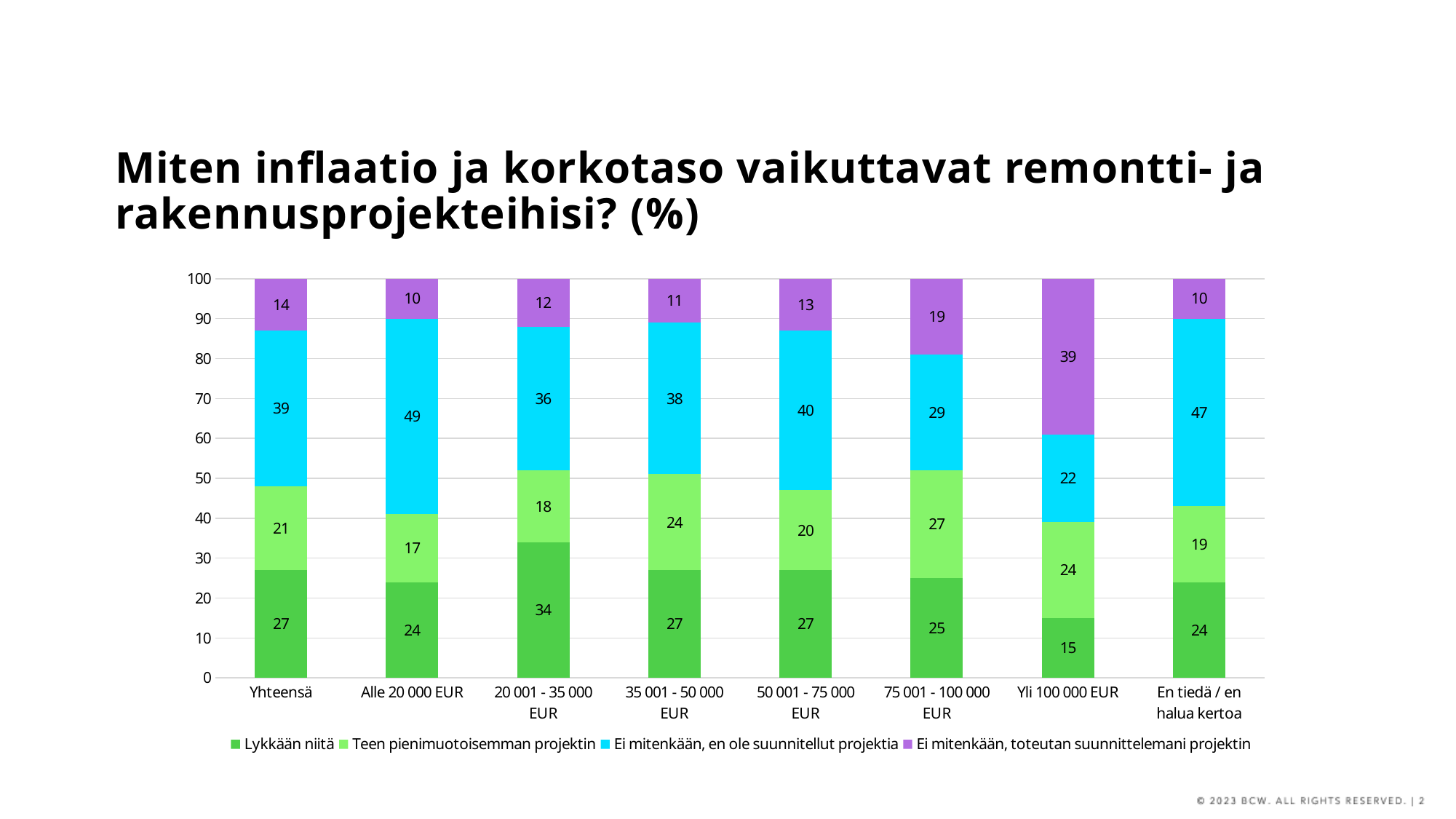
What is the total of the stacked bar for "Yli 100 000 EUR"? 100 Which category has the highest value for "Lykkään niitä"? 20 001 - 35 000 EUR Which category has the lowest value for "Ei mitenkään, en ole suunnitellut projektia"? Yli 100 000 EUR How many categories are shown on the x axis? 8 What kind of chart is shown on the slide? Stacked bar chart Which is larger: the "Teen pienimuotoisemman projektin" value for "75 001 - 100 000 EUR" or for "50 001 - 75 000 EUR"? 75 001 - 100 000 EUR What is the value of "Teen pienimuotoisemman projektin" for the "Yhteensä" category? 21 What is the difference between the "Ei mitenkään, en ole suunnitellut projektia" values for "Alle 20 000 EUR" and "Yhteensä"? 10 What is the value of "Ei mitenkään, en ole suunnitellut projektia" for the "Alle 20 000 EUR" category? 49 What is the value of "Lykkään niitä" for the "20 001 - 35 000 EUR" category? 34 What is the value of "Ei mitenkään, toteutan suunnittelemani projektin" for the "Yli 100 000 EUR" category? 39 How many series does the legend list? 4